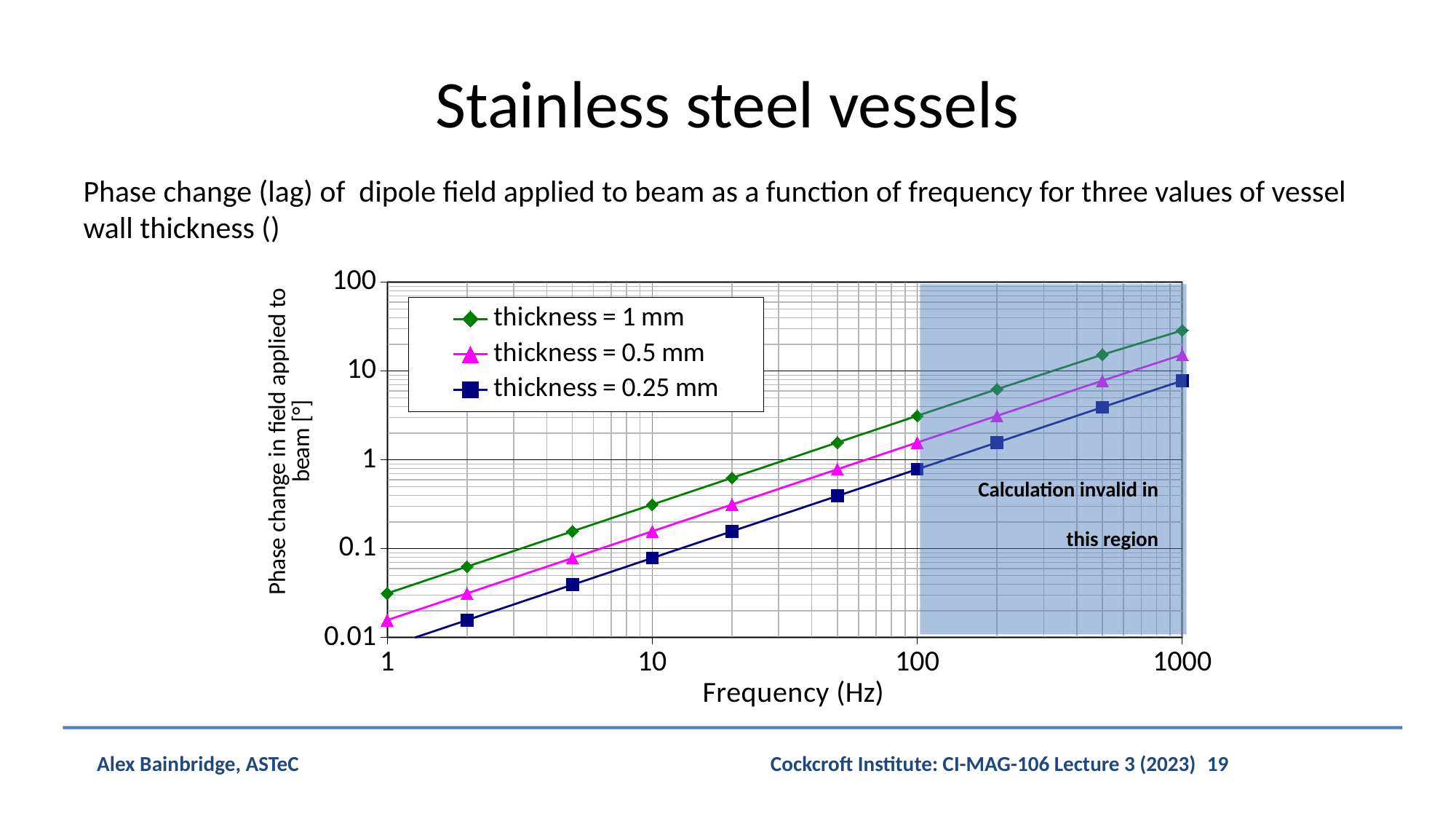
How many series does the legend list? 3 What is the label of the x axis? Frequency (Hz) How many data points are plotted for the thickness = 1 mm series? 10 Which series has the highest phase change at every frequency? thickness = 1 mm What kind of chart is shown on the slide? line chart Do the phase change values rise or fall as frequency increases? rise Which series has the lowest phase change at every frequency? thickness = 0.25 mm Is the value for thickness = 0.25 mm at 1000 Hz greater or less than 10? less Is the value for thickness = 1 mm at 100 Hz greater or less than 1? greater Is the value for thickness = 1 mm at 10 Hz greater or less than 0.1? greater At 100 Hz, which is larger: the value for thickness = 1 mm or thickness = 0.25 mm? thickness = 1 mm